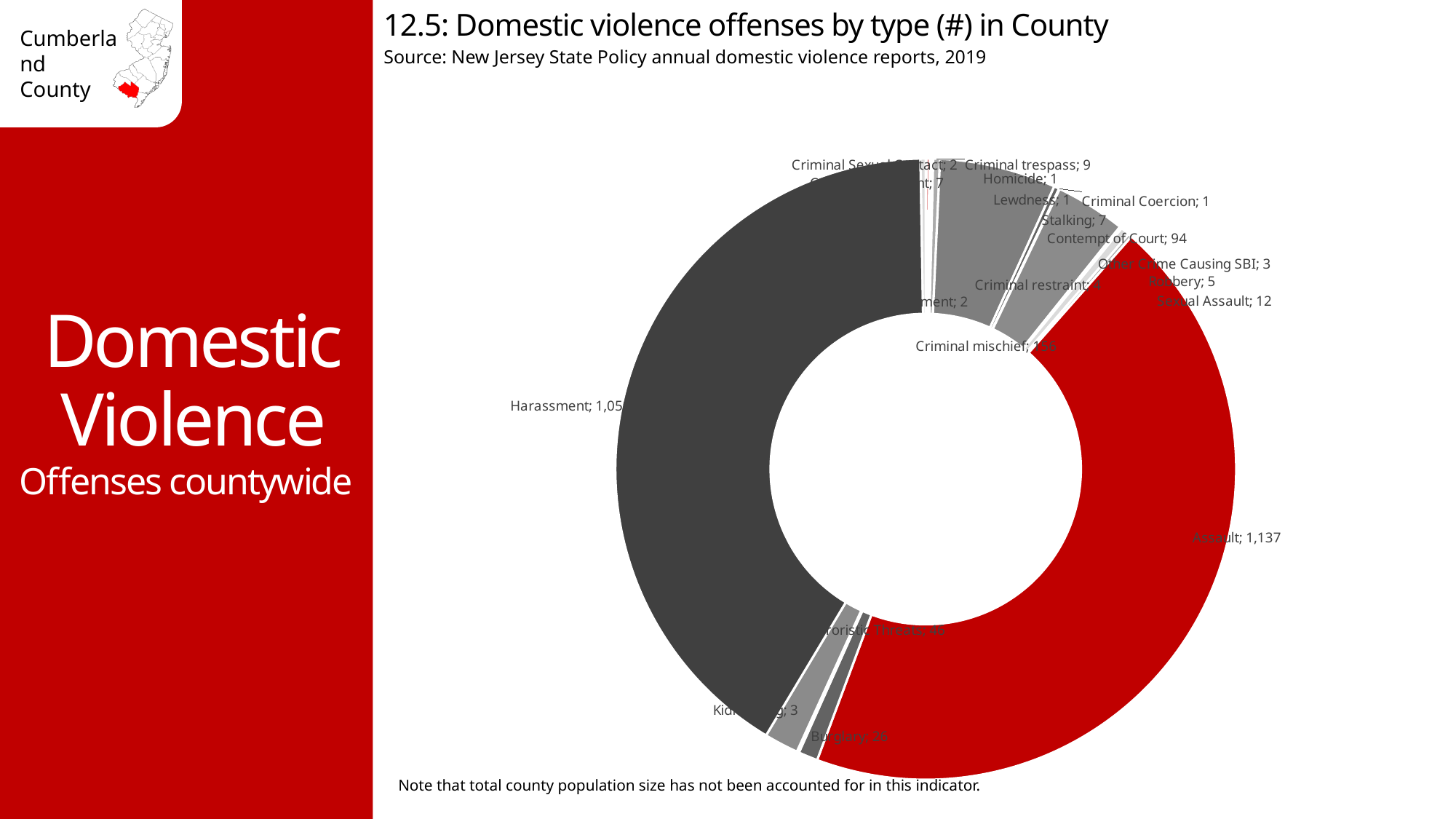
What is the value for Criminal trespass? 9 What is the value for Stalking? 7 What is the value for Contempt of Court? 94 What is the value for Homicide? 1 What type of chart is shown on the slide? Doughnut (pie) chart What year of data does the chart's source line cite? 2019 What is the difference between the values for Contempt of Court and Sexual Assault? 82 What is the value for Robbery? 5 What is the value for Sexual Assault? 12 Which is larger, the value for Criminal trespass or the value for Stalking? Criminal trespass Which offense type has the highest number of offenses? Assault How many domestic violence offenses of type Assault are shown? 1,137